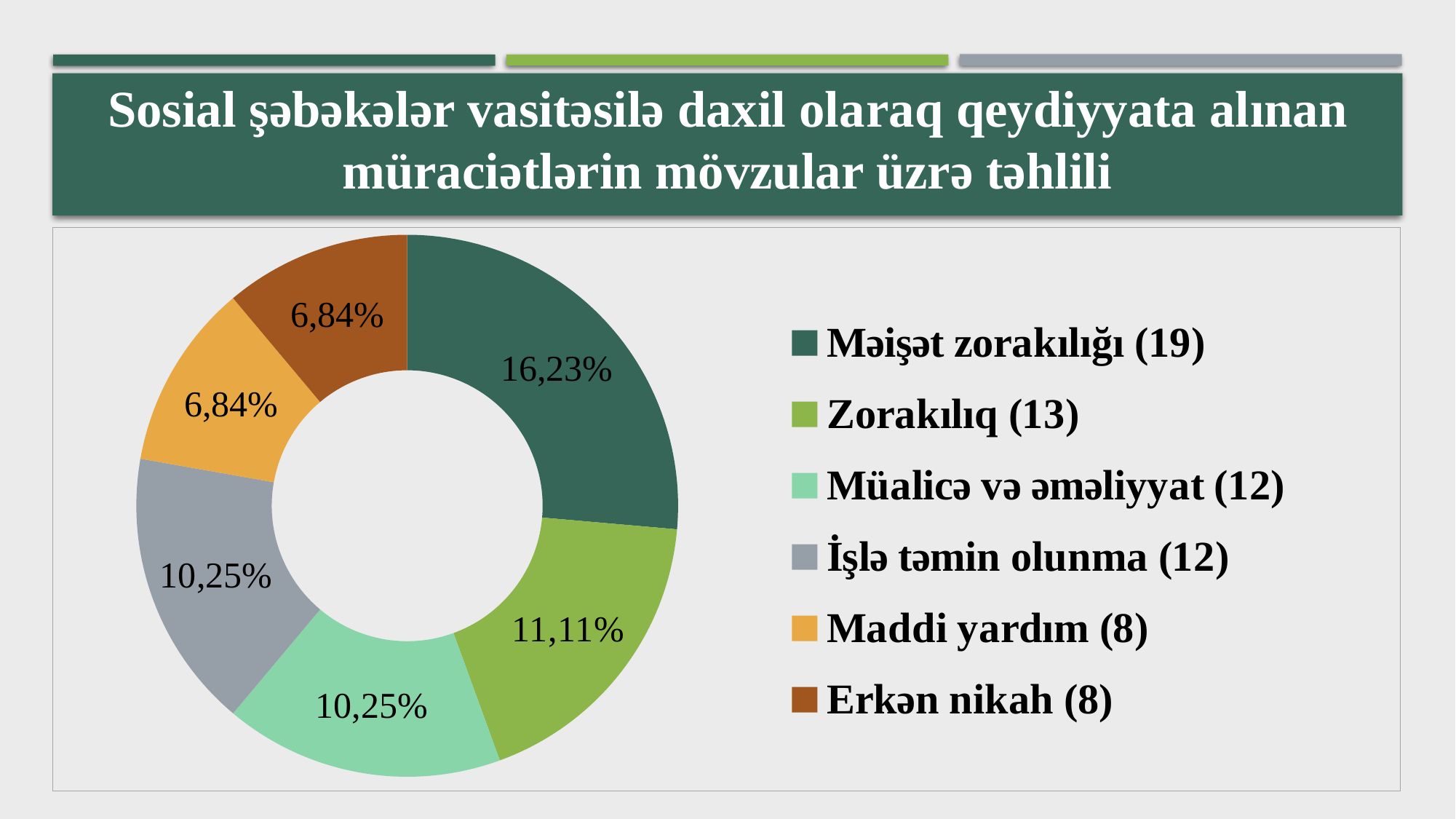
What percentage is shown for the Erkən nikah slice? 6,84% What percentage is shown for the Müalicə və əməliyyat slice? 10,25% How many categories does the chart show? 6 What kind of chart is shown on the slide? Doughnut (pie) chart What percentage is shown for the Məişət zorakılığı slice? 16,23% Which slice is larger, Zorakılıq or Maddi yardım? Zorakılıq What percentage is shown for the Zorakılıq slice? 11,11% How many cases does the legend show for Maddi yardım? 8 What is the difference in percentage points between the Məişət zorakılığı slice and the Zorakılıq slice? 5,12 Is the value for İşlə təmin olunma greater or less than 10%? greater How many cases does the legend show for Məişət zorakılığı? 19 Which category has the largest slice in the chart? Məişət zorakılığı